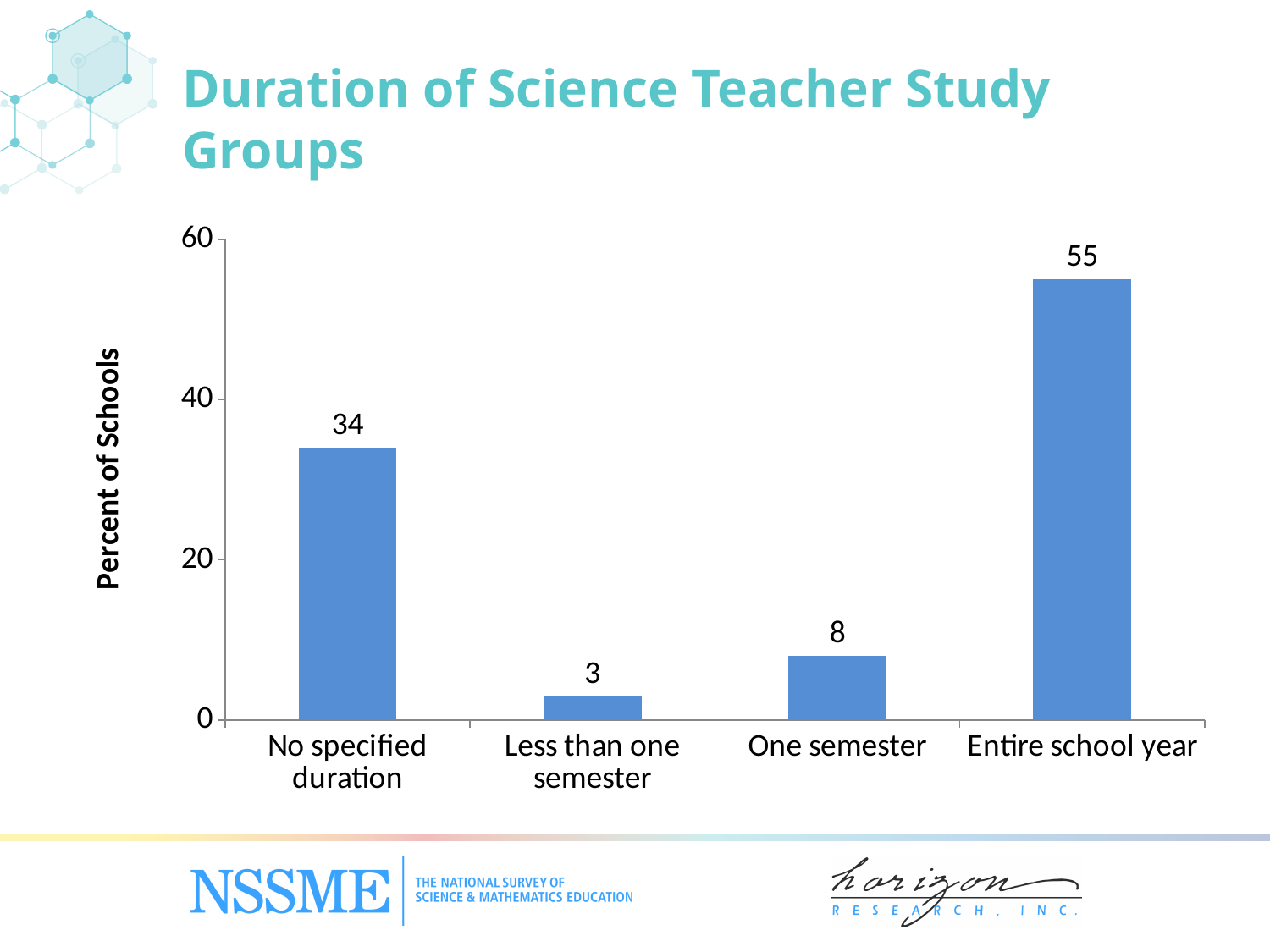
Which is larger, the value for 'One semester' or the value for 'No specified duration'? No specified duration What kind of chart is shown on the slide? Bar chart What is the value for 'Entire school year'? 55 What is the value for 'One semester'? 8 What is the value for 'Less than one semester'? 3 What is the difference between the values for 'Entire school year' and 'No specified duration'? 21 What percent of schools have science teacher study groups with no specified duration? 34 Is the value for 'Entire school year' greater or less than 40? greater How many duration categories are shown on the x axis? 4 Which duration category has the highest percent of schools? Entire school year Which duration category has the lowest percent of schools? Less than one semester What is the difference between the values for 'One semester' and 'Less than one semester'? 5